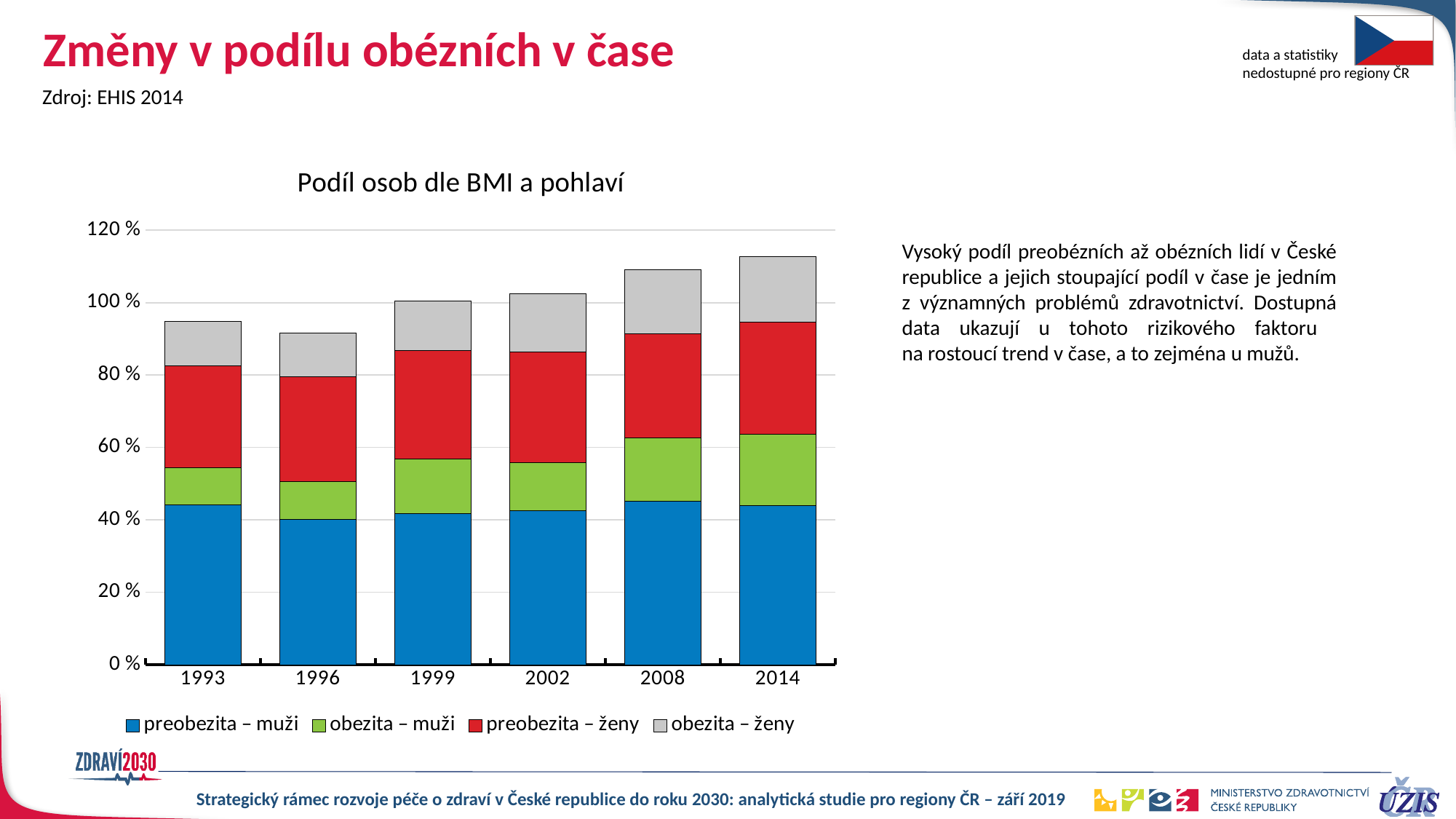
Which series is shown in blue in the chart? preobezita – muži What kind of chart is shown on the slide? stacked bar chart Is the total height of the stacked bar for 1993 greater or less than 100 %? less What is the title of the chart? Podíl osob dle BMI a pohlaví Which year has the tallest stacked bar in the chart? 2014 Which stacked bar is taller, 2014 or 1993? 2014 Is the value for preobezita – muži in 2008 greater or less than 40 %? greater Is the total height of the stacked bar for 2014 greater or less than 100 %? greater How many years are shown on the x axis of the chart? 6 Which year has the shortest stacked bar in the chart? 1996 How many series does the chart legend list? 4 Do the total stacked bar heights rise or fall from 1996 to 2014? rise